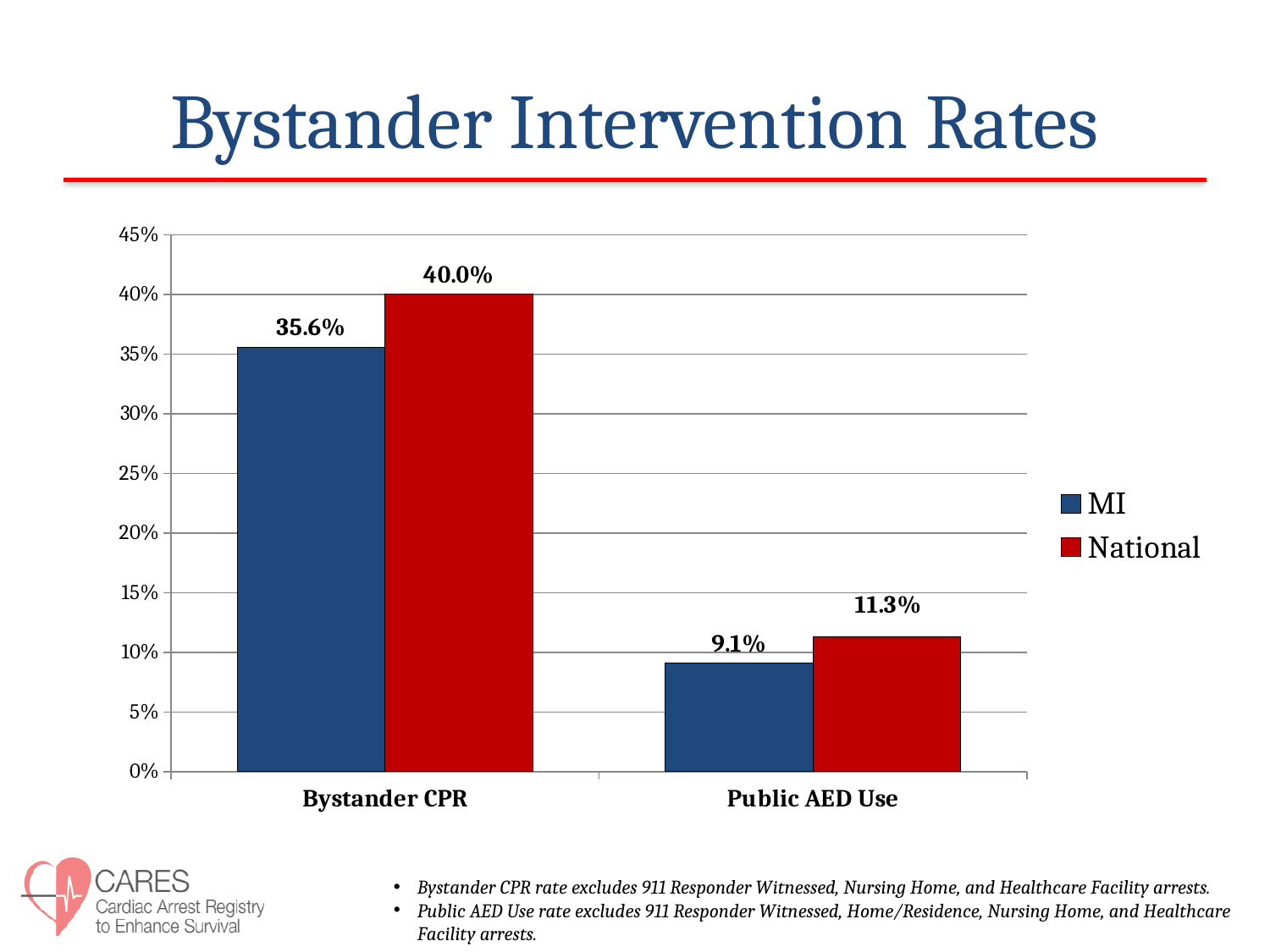
What is the National value for Bystander CPR? 40.0% Which bar has the highest value on the chart? National, Bystander CPR Which bar has the lowest value on the chart? MI, Public AED Use What is the difference between the National and MI values for Public AED Use? 2.2% What is the National value for Public AED Use? 11.3% How many series does the legend list? 2 How many categories are shown on the x axis? 2 What is the difference between the National and MI values for Bystander CPR? 4.4% What is the MI value for Public AED Use? 9.1% What kind of chart is shown on the slide? Bar chart What is the MI value for Bystander CPR? 35.6% For Public AED Use, which is larger, MI or National? National